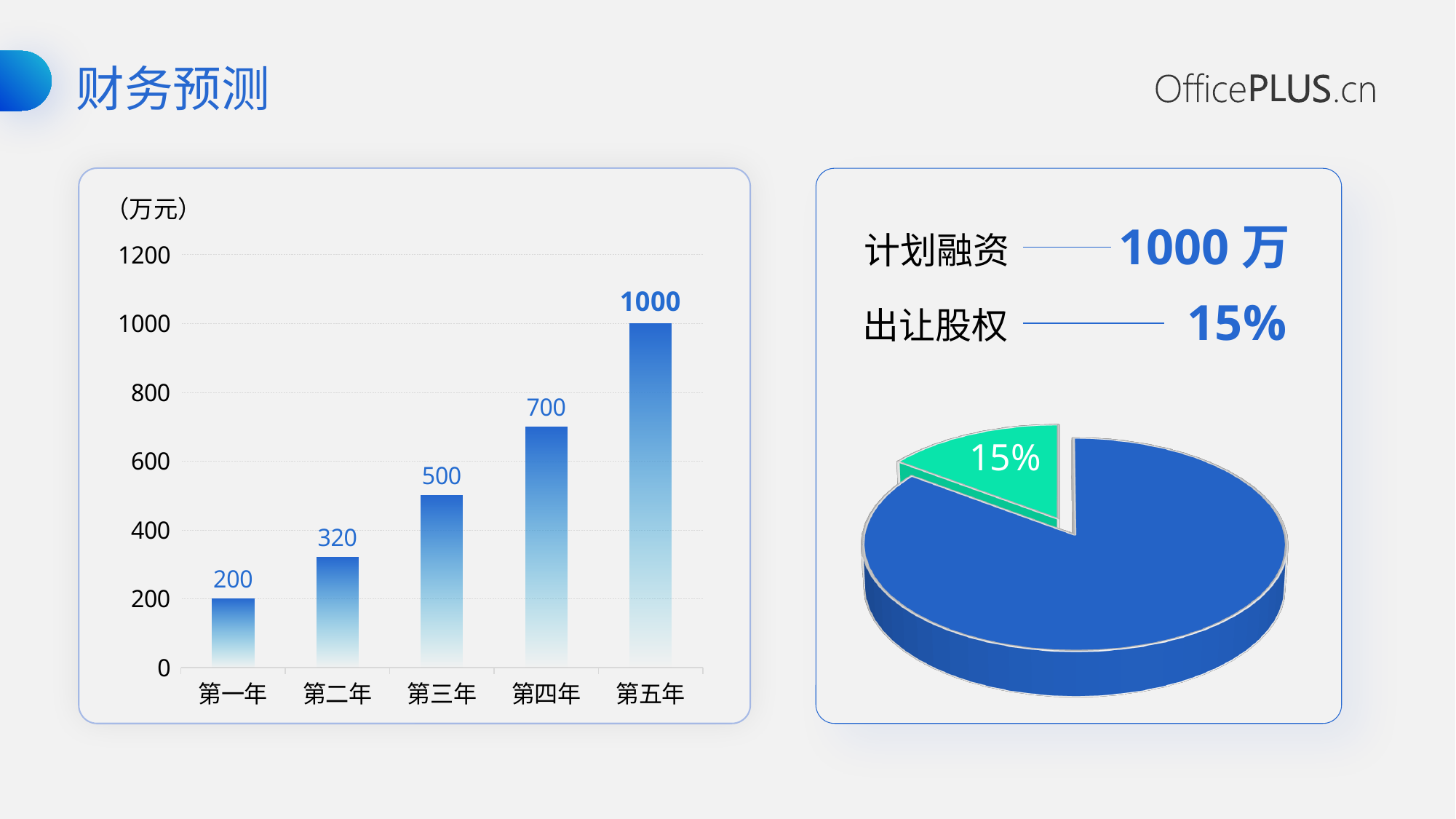
In the bar chart on the left, what is the difference between the values for 第二年 and 第一年? 120 In the bar chart on the left, what is the value for 第一年? 200 How many categories are shown in the bar chart on the left? 5 What kind of chart is on the left side of the slide? bar chart In the bar chart on the left, what is the value for 第三年? 500 In the bar chart on the left, is the value for 第四年 greater or less than 600? greater In the bar chart on the left, which is larger, the value for 第二年 or 第三年? 第三年 In the bar chart on the left, which year has the lowest value? 第一年 In the bar chart on the left, what is the difference between the values for 第五年 and 第四年? 300 In the bar chart on the left, which year has the highest value? 第五年 In the pie chart on the right, what share does the green slice represent? 15% In the bar chart on the left, do the values rise or fall from 第一年 to 第五年? rise